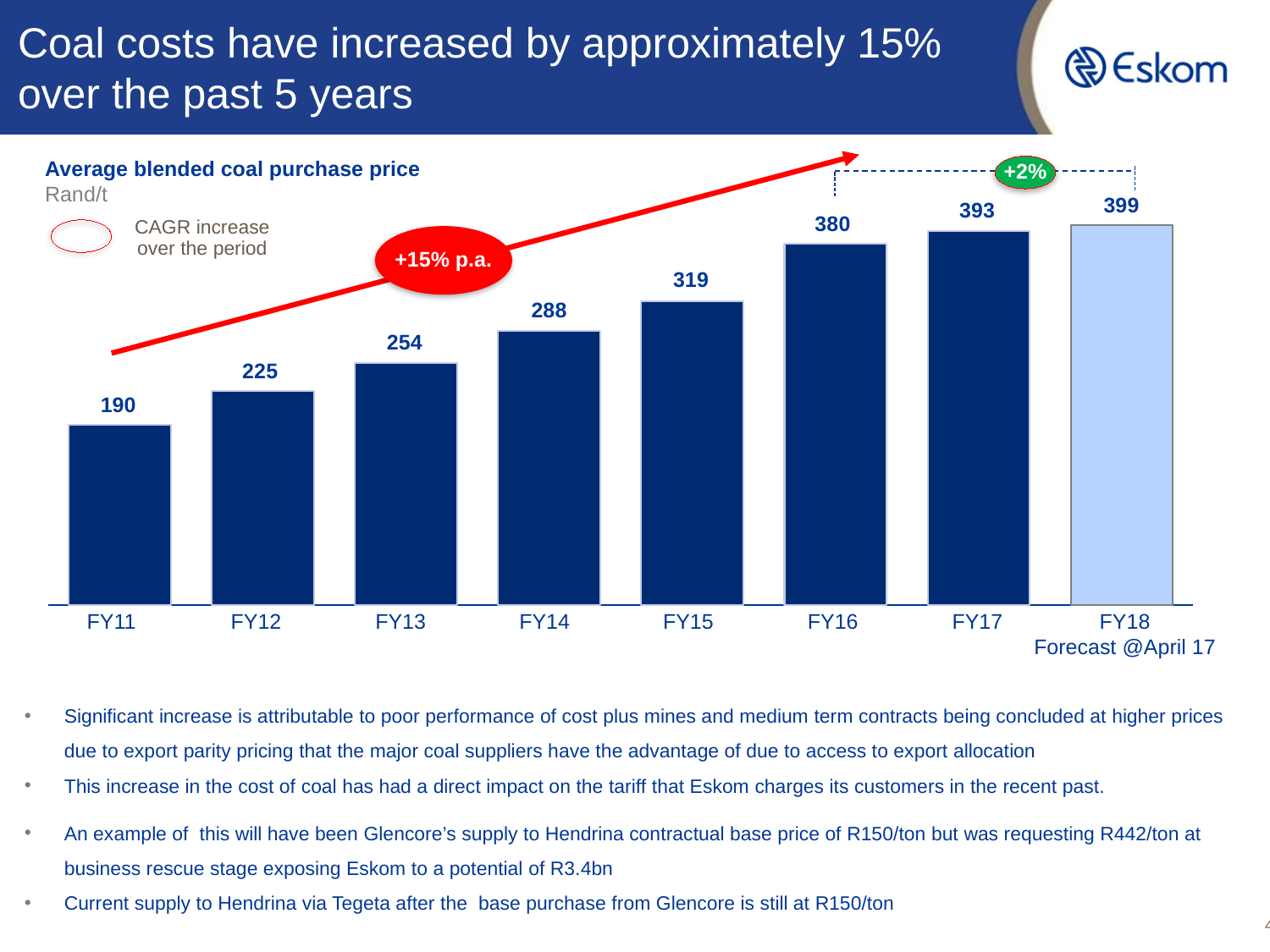
What is the forecast value for FY18? 399 What kind of chart is shown on the slide? Bar chart Which fiscal year has the lowest average blended coal purchase price? FY11 Do the values rise or fall from FY11 to FY18? Rise What is the value shown for FY11? 190 What unit is the average blended coal purchase price shown in? Rand/t Which fiscal year has the highest average blended coal purchase price? FY18 What is the average blended coal purchase price for FY14? 288 How many fiscal years are shown on the chart? 8 What is the difference between the FY17 and FY11 values? 203 Which is larger, the value for FY13 or the value for FY15? FY15 By how much does the FY16 value exceed the FY15 value? 61